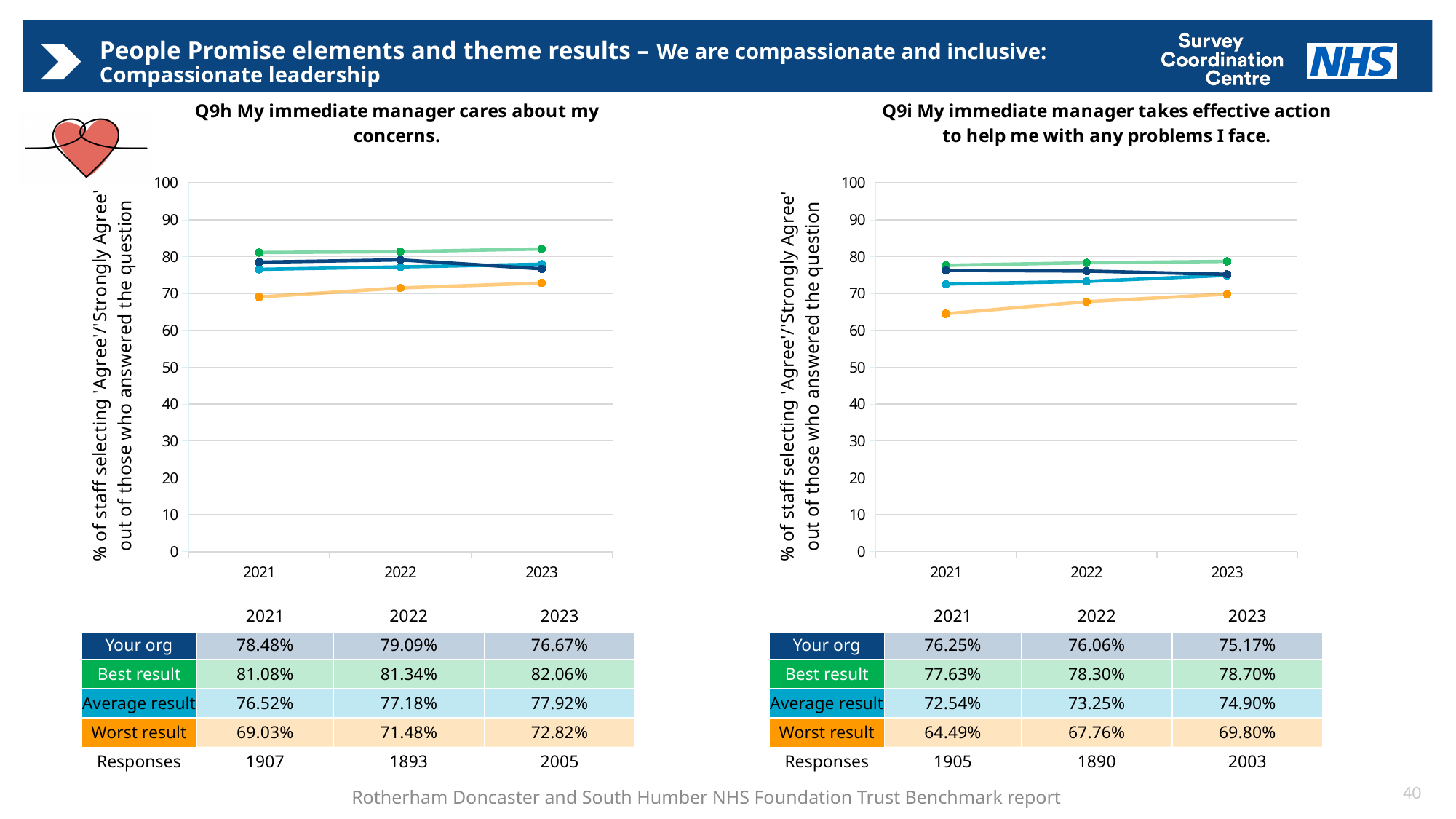
How many years are plotted on the x axis of the Q9h chart? 3 In the Q9h chart, which year had the highest 'Best result' value? 2023 In the Q9i chart, does the 'Worst result' series rise or fall from 2021 to 2023? Rise In the Q9h chart, what was the 'Your org' value in 2022? 79.09% How many series are plotted in the Q9i chart? 4 In the Q9i chart, which is larger in 2023: 'Your org' or 'Average result'? Your org In the Q9i chart, what was the 'Worst result' value in 2021? 64.49% In the Q9i chart, which year had the lowest 'Your org' value? 2023 In the Q9h chart, how many responses were recorded in 2023? 2005 In the Q9h chart, what is the difference between the 'Best result' and 'Your org' values in 2023? 5.39% In the Q9i chart, is the 'Worst result' value for 2021 greater or less than 70? less What type of chart is used for Q9h? Line chart